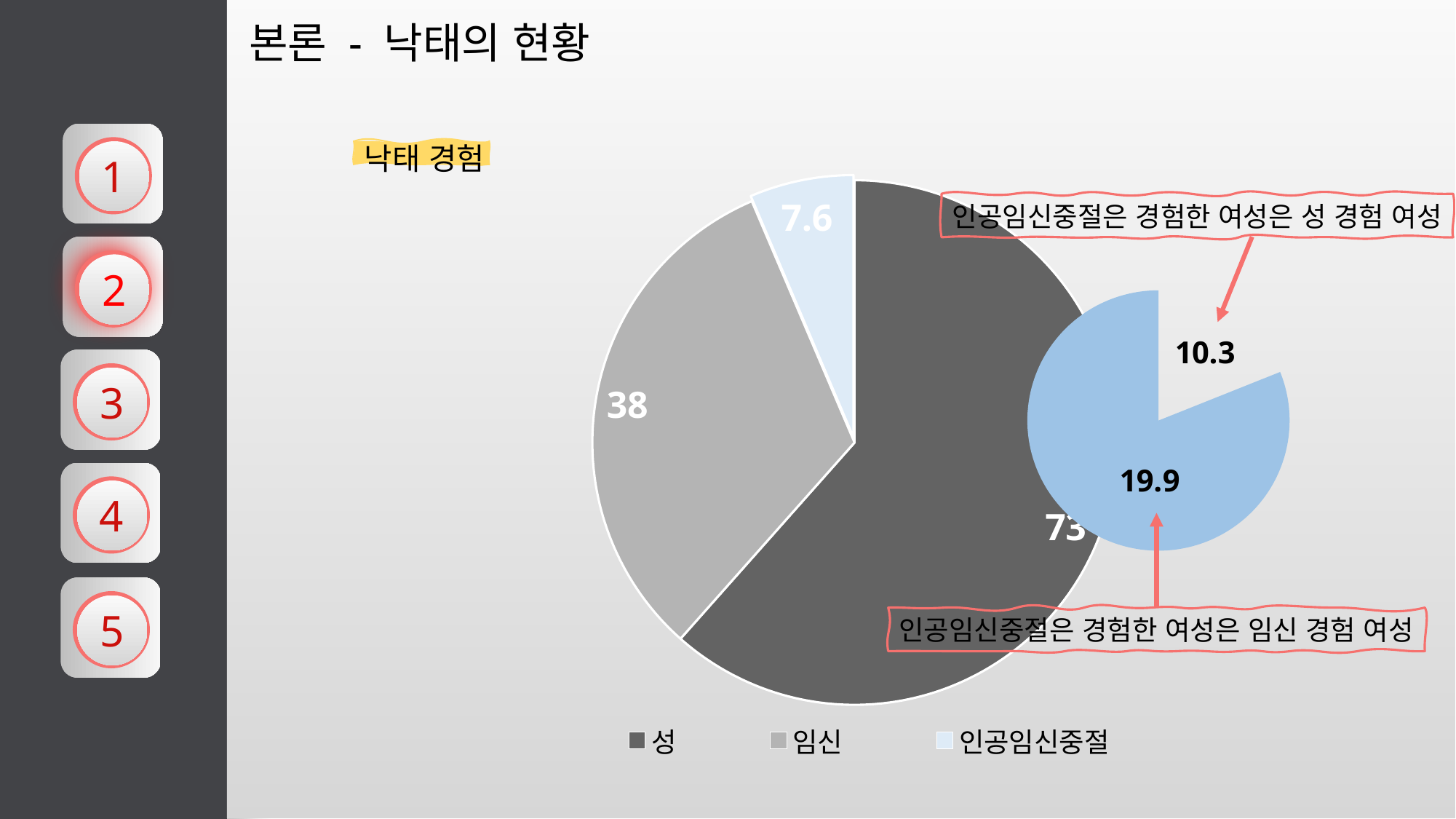
What is the highlighted heading above the pie chart? 낙태 경험 Which is larger in the pie chart, the value for 성 or the value for 임신? 성 What is the value shown for 성 in the pie chart? 73 Which category has the largest slice in the pie chart? 성 How many entries does the legend of the pie chart list? 3 How many slices does the main pie chart have? 3 What is the difference between the values for 임신 and 인공임신중절 in the pie chart? 30.4 What kind of chart is shown on the slide? pie chart What is the value shown for 인공임신중절 in the pie chart? 7.6 What are the legend entries of the pie chart, from left to right? 성, 임신, 인공임신중절 Which category has the smallest slice in the pie chart? 인공임신중절 What is the value shown for 임신 in the pie chart? 38